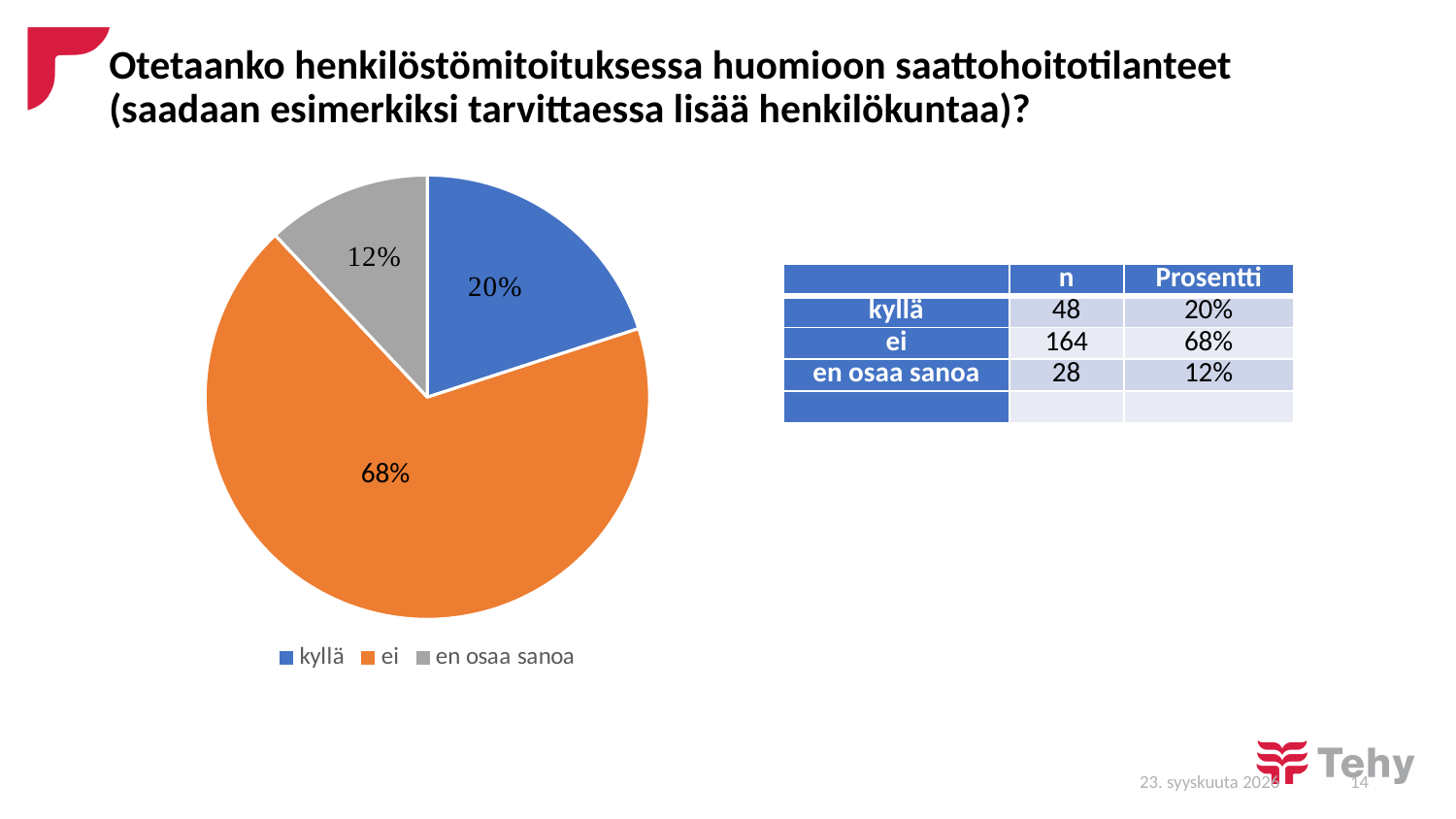
What percentage of the pie is the 'en osaa sanoa' slice? 12% What colour is the 'ei' slice in the pie chart? orange Which category has the smallest slice of the pie? en osaa sanoa What is the difference in percentage points between the 'ei' slice and the 'kyllä' slice? 48 What percentage of the pie is the 'kyllä' slice? 20% What percentage of the pie is the 'ei' slice? 68% How many slices does the pie chart have? 3 What kind of chart is shown on the slide? pie chart Which slice is larger, 'kyllä' or 'en osaa sanoa'? kyllä Which category has the largest slice of the pie? ei How many entries does the legend list? 3 What colour is the 'en osaa sanoa' slice in the pie chart? grey